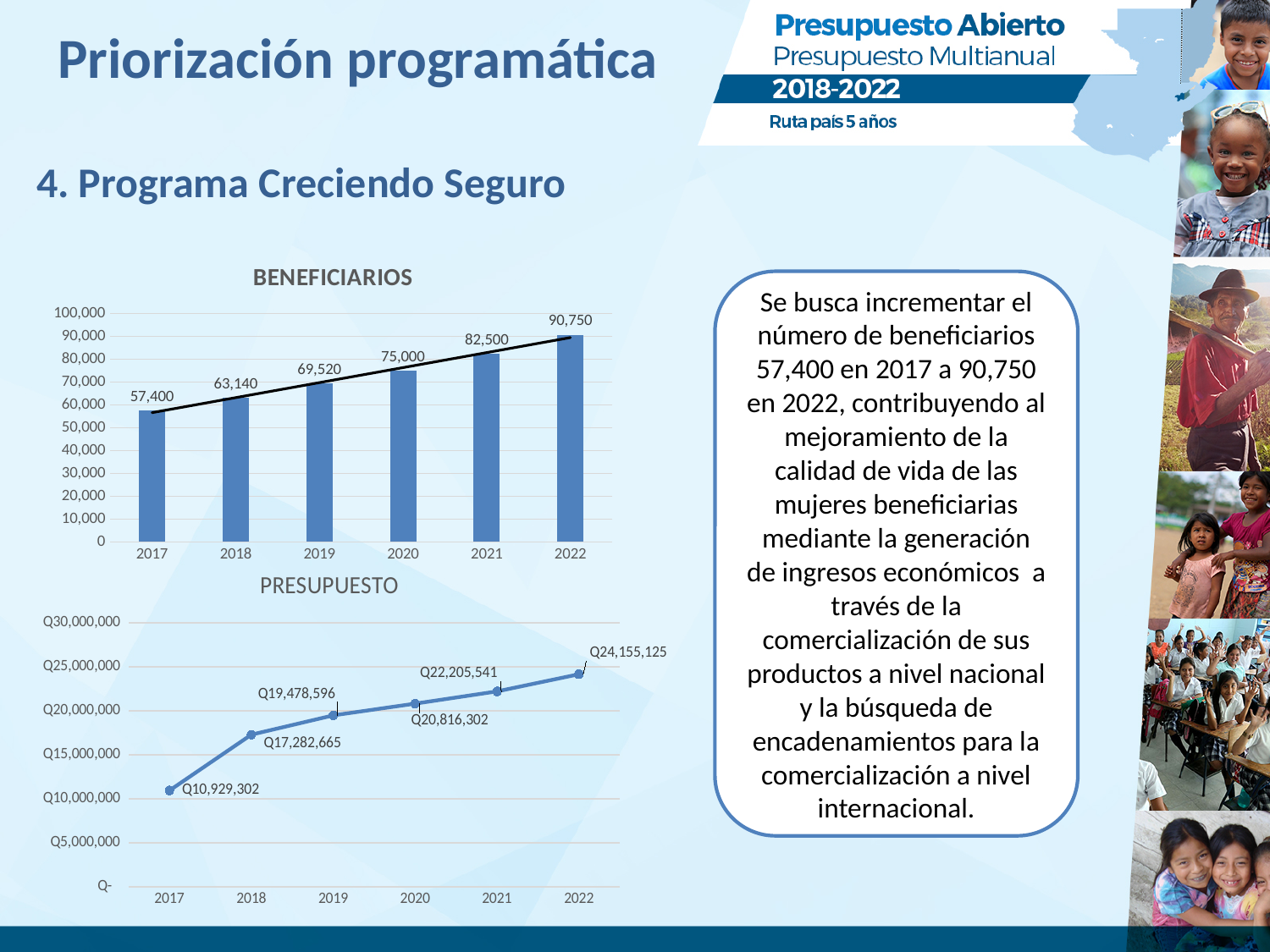
What kind of chart is the BENEFICIARIOS chart? Bar chart In the PRESUPUESTO chart, what is the value for 2017? Q10,929,302 In the BENEFICIARIOS chart, which year has the highest value? 2022 In the BENEFICIARIOS chart, do the values rise or fall from 2017 to 2022? Rise In the BENEFICIARIOS chart, what is the difference between the values for 2021 and 2020? 7,500 In the PRESUPUESTO chart, what is the value for 2020? Q20,816,302 How many years are shown in the BENEFICIARIOS chart? 6 In the BENEFICIARIOS chart, what is the difference between the values for 2022 and 2017? 33,350 In the BENEFICIARIOS chart, what is the value for 2019? 69,520 In the BENEFICIARIOS chart, which year has the lowest value? 2017 What kind of chart is the PRESUPUESTO chart? Line chart In the PRESUPUESTO chart, what is the difference between the values for 2022 and 2017? Q13,225,823